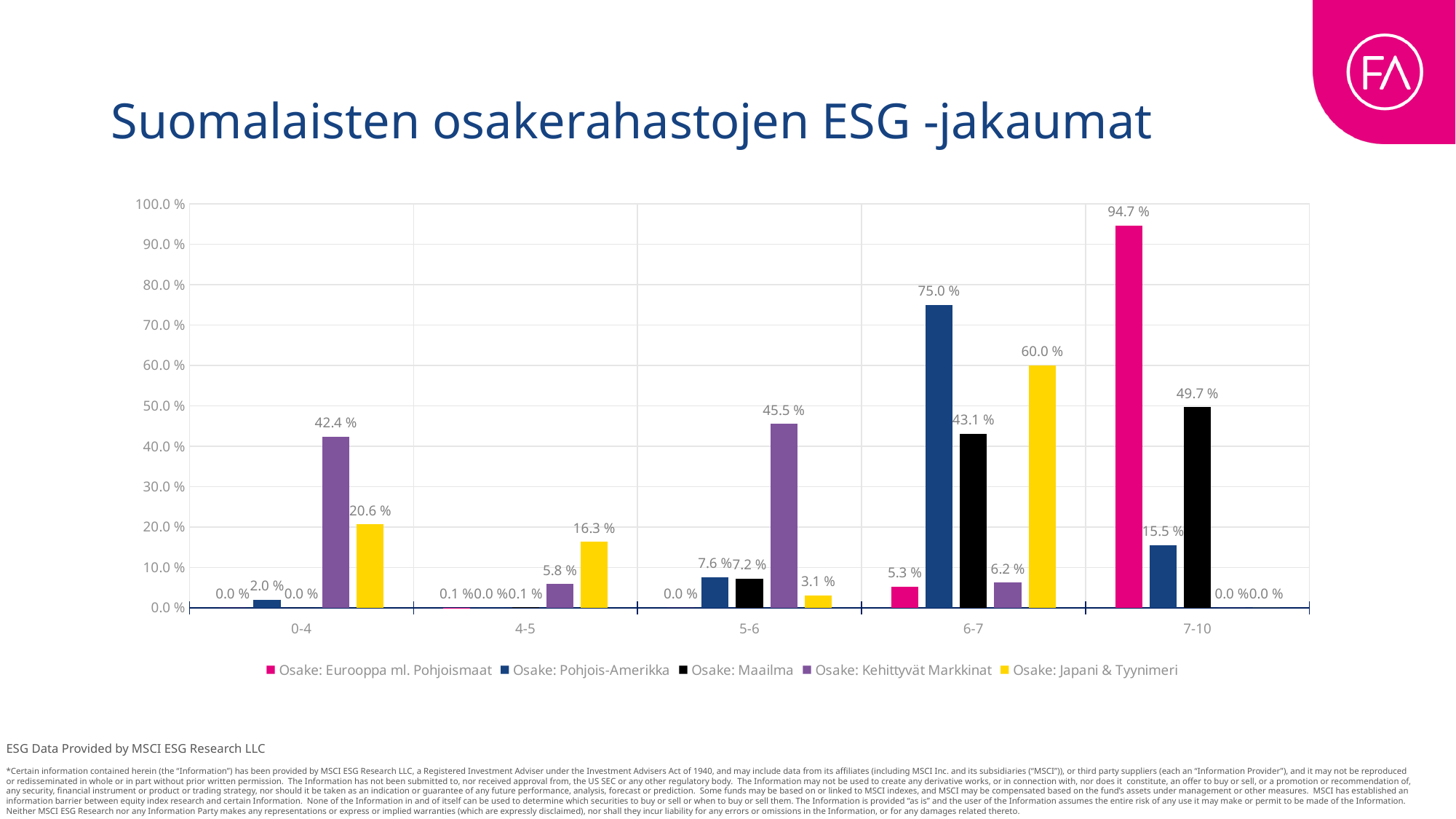
What is the value for Osake: Japani & Tyynimeri in the 4-5 category? 16.3 % What is the value for Osake: Pohjois-Amerikka in the 6-7 category? 75.0 % What is the value for Osake: Kehittyvät Markkinat in the 0-4 category? 42.4 % How many categories are shown on the x axis? 5 How many series does the legend list? 5 What is the title of the slide? Suomalaisten osakerahastojen ESG -jakaumat What is the value for Osake: Eurooppa ml. Pohjoismaat in the 7-10 category? 94.7 % Which is larger in the 6-7 category: Osake: Japani & Tyynimeri or Osake: Maailma? Osake: Japani & Tyynimeri What is the difference between Osake: Pohjois-Amerikka and Osake: Maailma in the 6-7 category? 31.9 % In which category does Osake: Kehittyvät Markkinat have its highest value? 5-6 In which category does Osake: Maailma have its highest value? 7-10 What kind of chart is shown on the slide? Bar chart